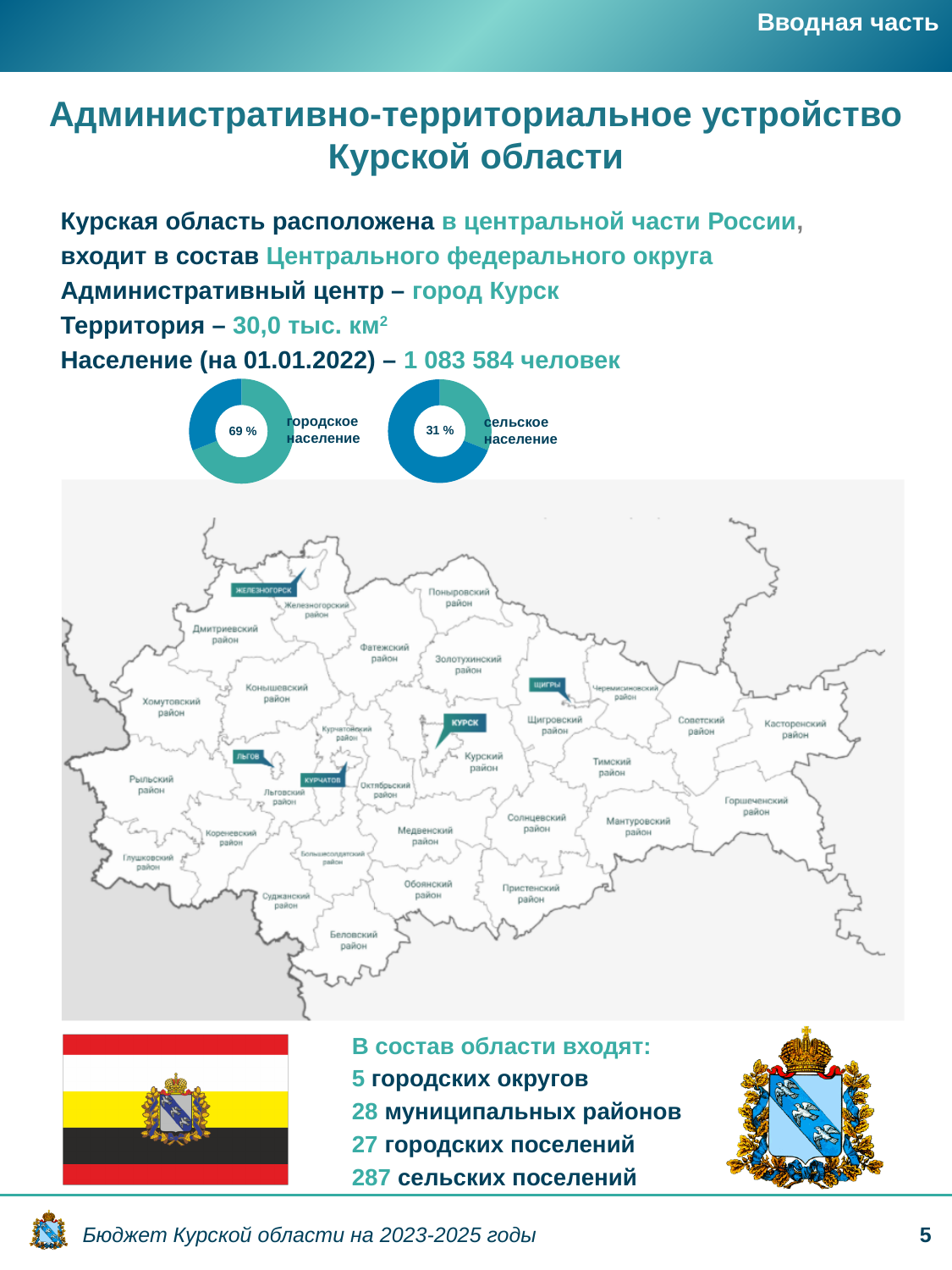
What is the label next to the left donut chart? городское население What kind of chart is used to show the urban and rural population shares on the slide? donut (pie) chart In the right donut chart, what share is shown for сельское население (rural population)? 31 % In the left donut chart, what share is shown for городское население (urban population)? 69 % What is the label next to the right donut chart? сельское население What do the urban (69 %) and rural (31 %) population shares in the donut charts add up to? 100 % What is the difference between the urban population share (69 %) and the rural population share (31 %) shown in the donut charts? 38 % How many donut charts are shown on the slide? 2 Which is larger according to the two donut charts: the share of городское население or сельское население? городское население